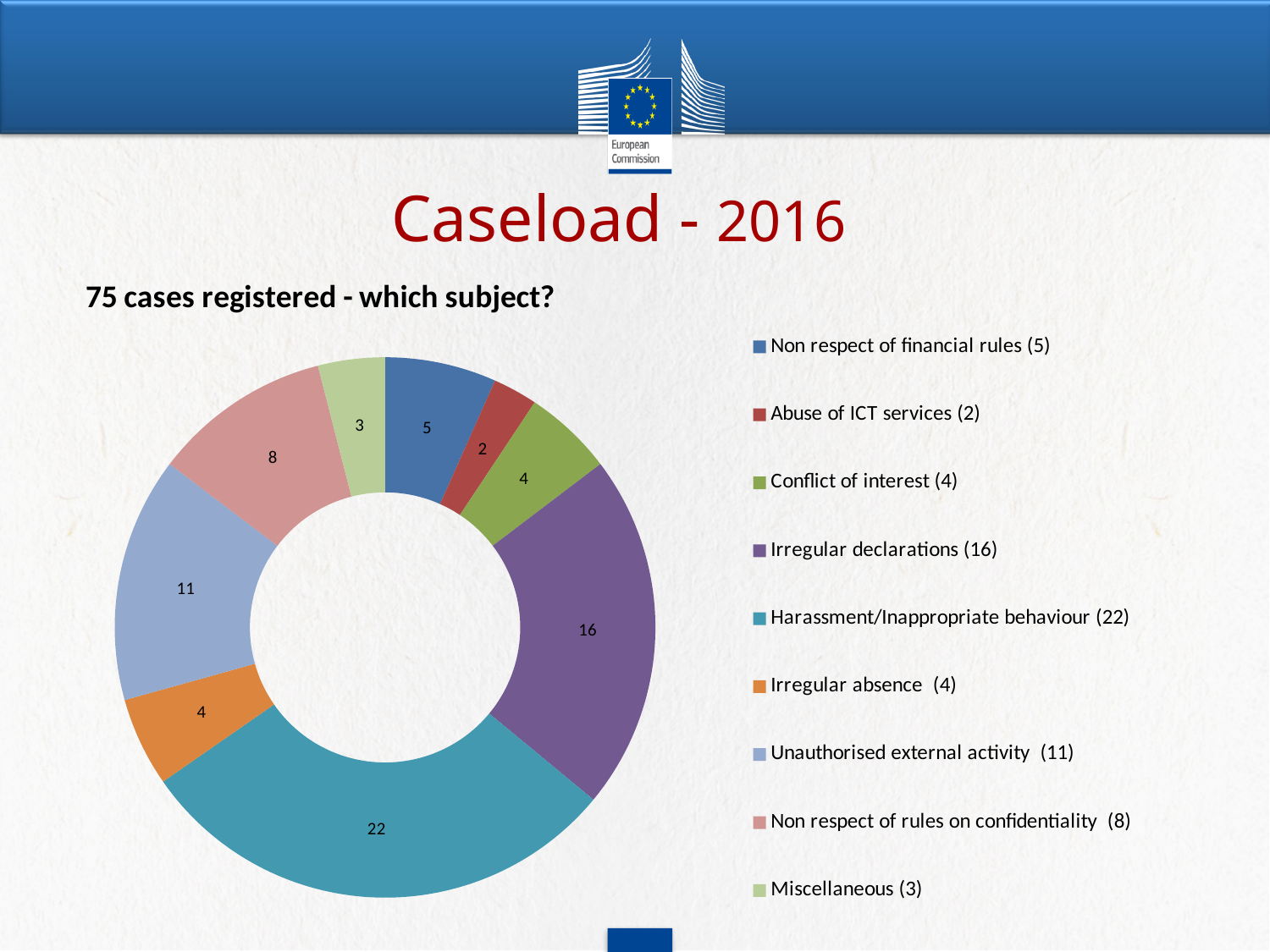
Which category has the largest number of cases? Harassment/Inappropriate behaviour Which has more cases: Non respect of financial rules or Miscellaneous? Non respect of financial rules How many categories does the chart show? 9 How many cases are in the Irregular declarations category? 16 What kind of chart is shown on the slide? Doughnut (pie) chart How many cases are in the Unauthorised external activity category? 11 How many cases are in the Harassment/Inappropriate behaviour category? 22 What is the title of the chart? 75 cases registered - which subject? Which category has the smallest number of cases? Abuse of ICT services What is the difference between the number of Harassment/Inappropriate behaviour cases and Irregular declarations cases? 6 How many cases are in the Non respect of rules on confidentiality category? 8